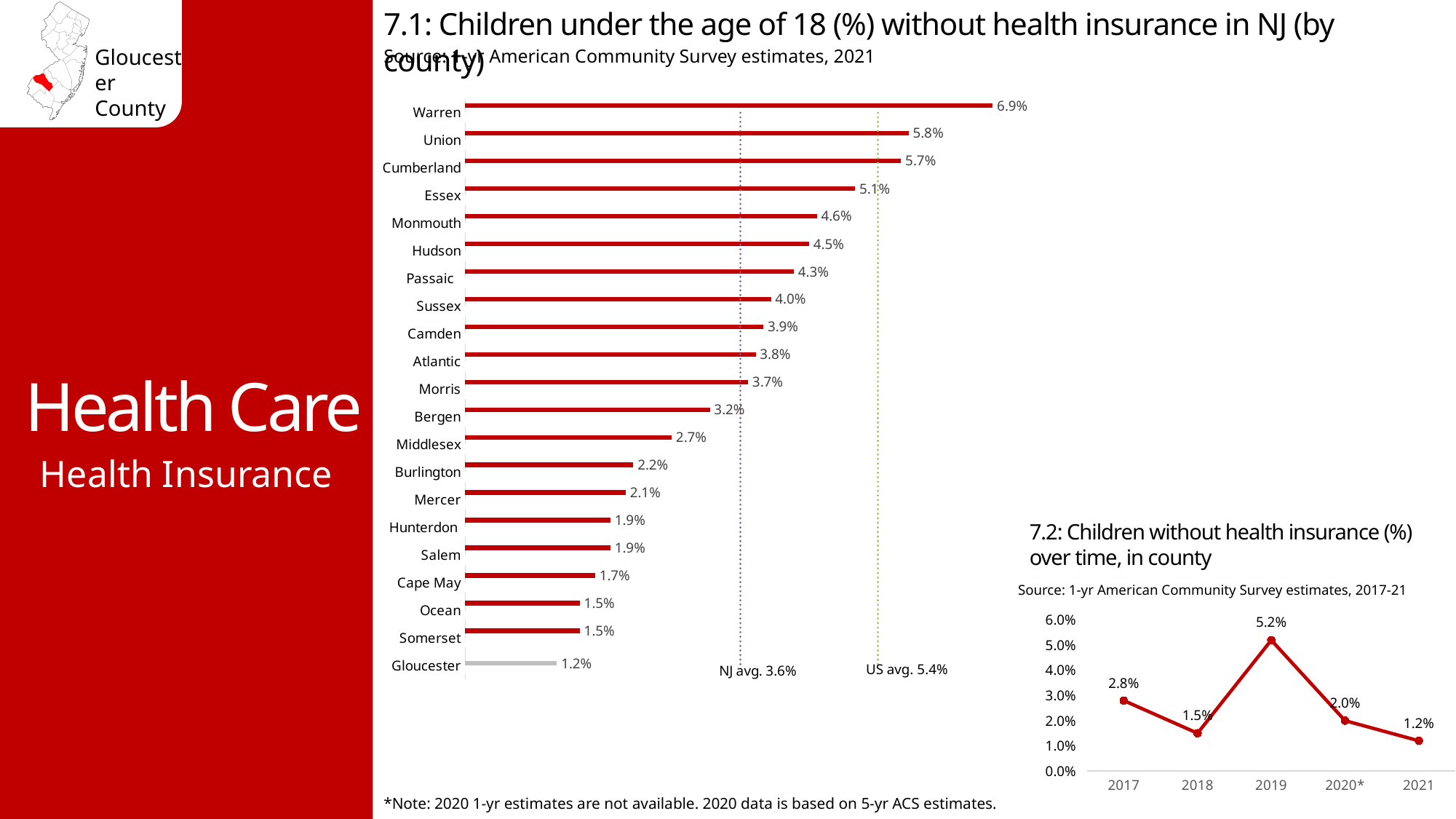
In chart 7.1, which county has the highest percentage of children without health insurance? Warren In chart 7.2, which year has the highest value? 2019 In chart 7.1, how many counties are shown? 21 What kind of chart is chart 7.2 (children without health insurance over time)? Line chart In chart 7.1, what NJ average is marked by the dotted reference line? 3.6% In chart 7.1, which county has a larger value, Camden or Burlington? Camden In chart 7.1 (children under 18 without health insurance by county), what is the value for Gloucester? 1.2% In chart 7.1, which county has the lowest percentage of children without health insurance? Gloucester In chart 7.1, what is the value for Cumberland? 5.7% In chart 7.2, what is the difference between the values for 2019 and 2021? 4.0% In chart 7.1, what is the difference between the values for Warren and Gloucester? 5.7% In chart 7.2, what is the value for 2019? 5.2%